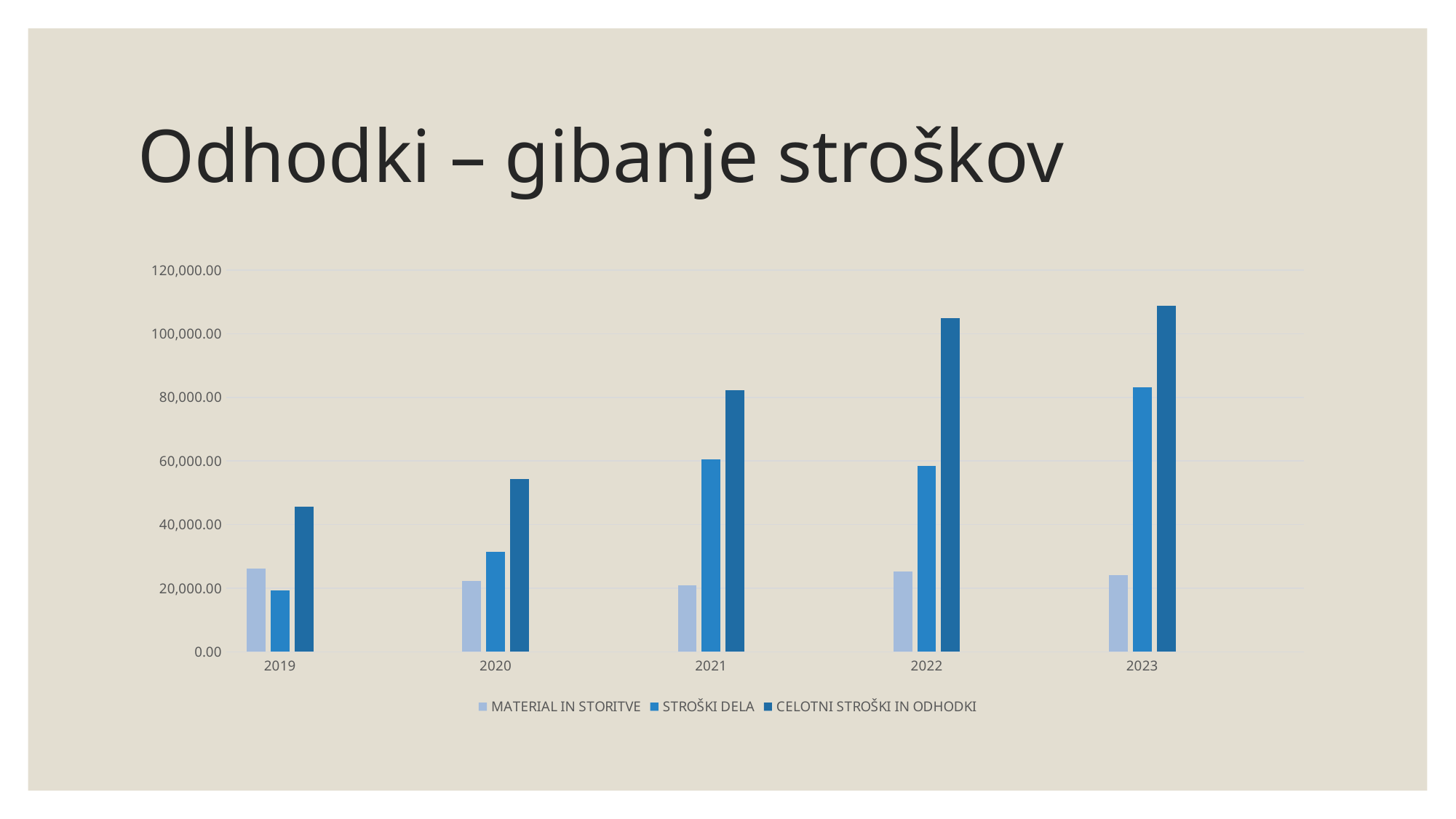
Is the value for STROŠKI DELA in 2023 greater or less than 80,000.00? greater In which year is the value for CELOTNI STROŠKI IN ODHODKI lowest? 2019 Is the value for CELOTNI STROŠKI IN ODHODKI in 2022 greater or less than 100,000.00? greater In 2021, which is larger: STROŠKI DELA or MATERIAL IN STORITVE? STROŠKI DELA What is the title of the slide containing the chart? Odhodki – gibanje stroškov How many series does the chart's legend list? 3 In which year is the value for STROŠKI DELA highest? 2023 How many years are shown on the x axis of the chart? 5 What kind of chart is shown on the slide? bar chart Do the values for CELOTNI STROŠKI IN ODHODKI rise or fall from 2019 to 2023? rise In 2019, which is larger: MATERIAL IN STORITVE or STROŠKI DELA? MATERIAL IN STORITVE